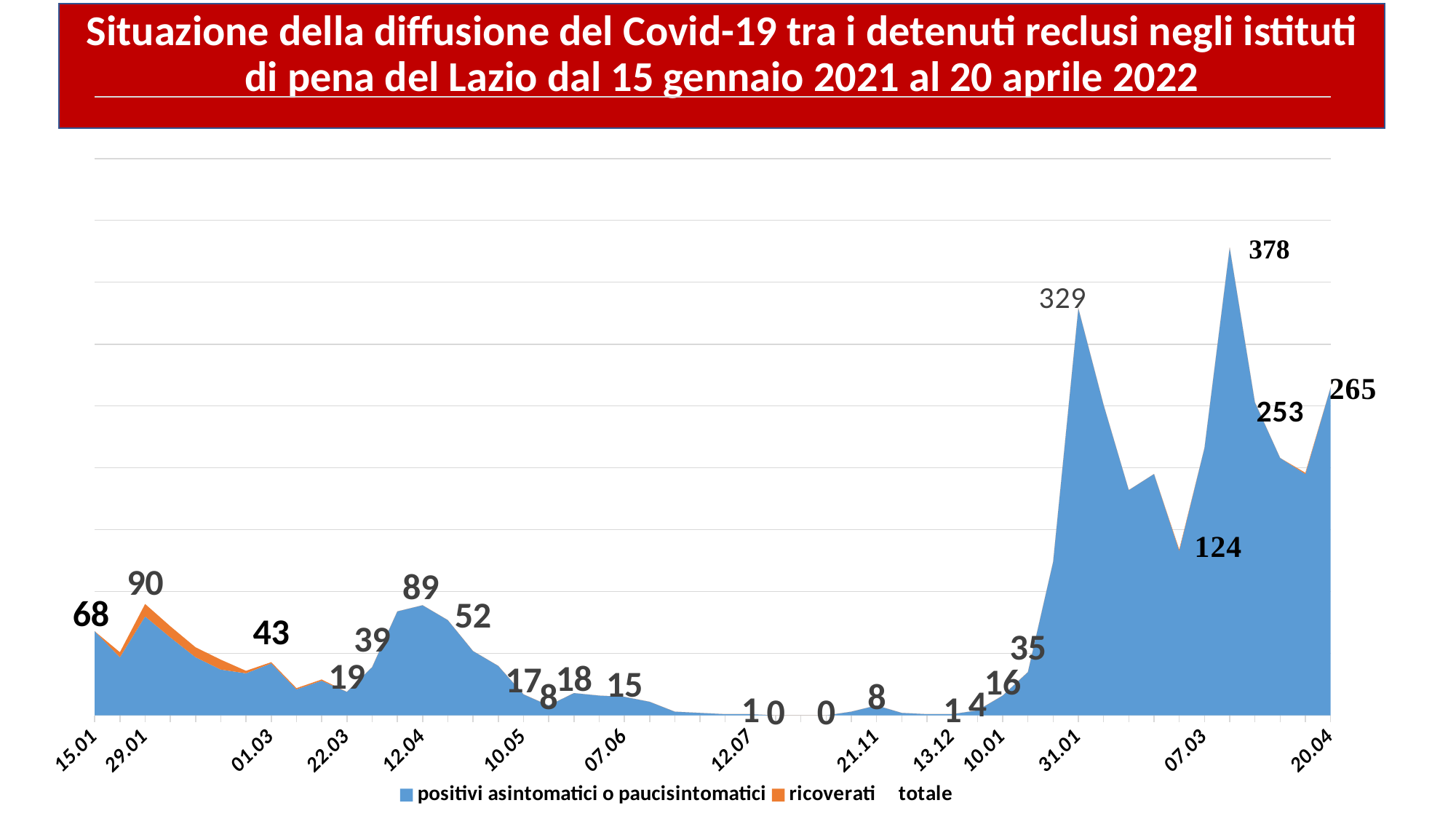
What kind of chart is shown on the slide? area chart What is the value labelled at 31.01? 329 Which date has the larger value, 31.01 or 20.04? 31.01 How many series does the legend list? 3 What is the value labelled at 20.04, the last date on the x axis? 265 What is the value labelled at 15.01, the first date on the x axis? 68 What is the value labelled at 29.01? 90 Do the values rise or fall between 31.01 and 07.03? fall What is the highest value labelled on the chart? 378 What is the lowest value labelled on the chart? 0 Which legend entry is shown in orange? ricoverati What is the difference between the peak value of 378 and the value at 31.01? 49